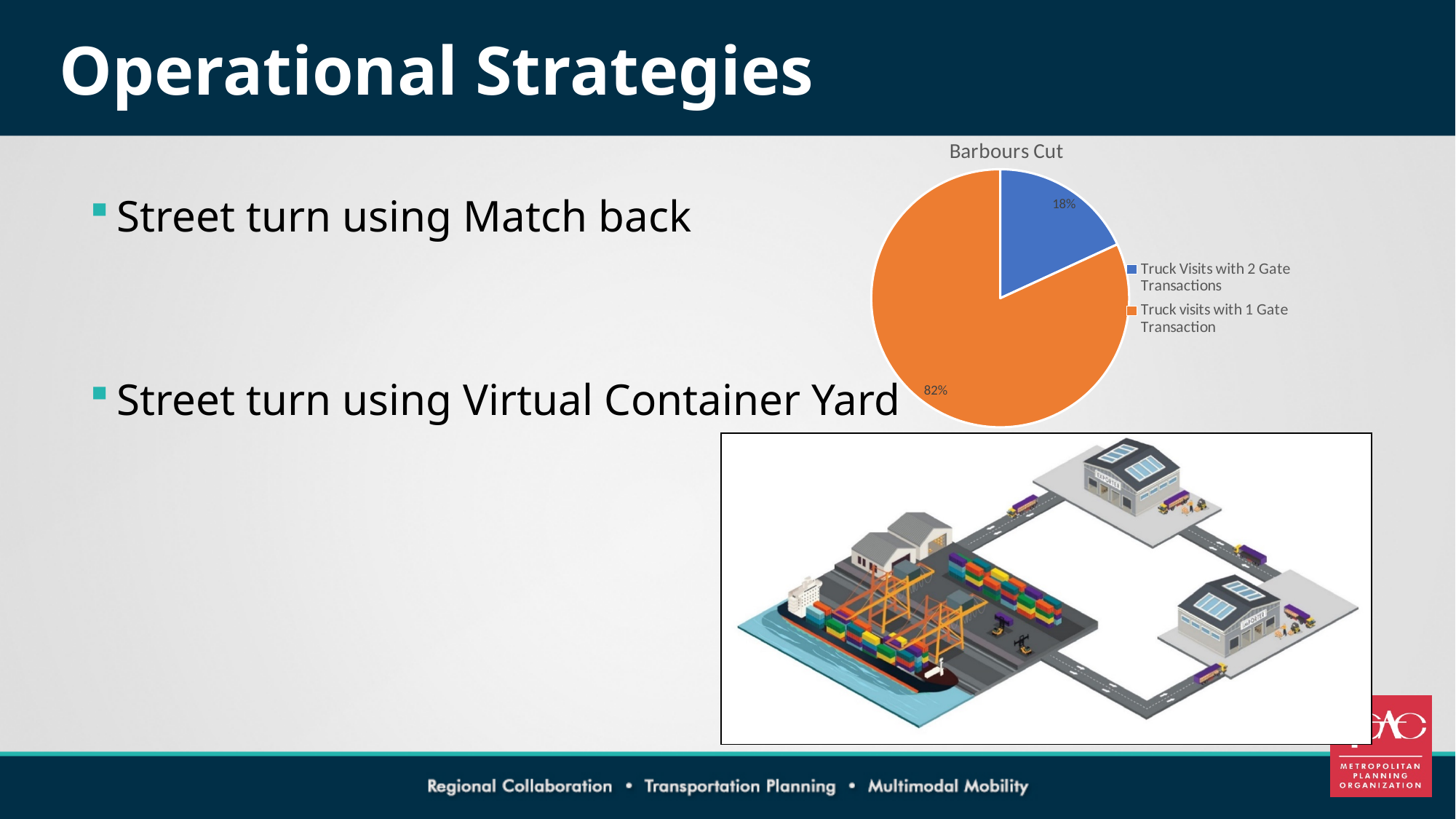
Which category has the largest slice of the pie? Truck visits with 1 Gate Transaction What share of the pie is Truck Visits with 2 Gate Transactions? 18% What is the difference in percentage points between the 1 Gate Transaction slice and the 2 Gate Transactions slice? 64 What colour is the slice for Truck Visits with 2 Gate Transactions? blue How many categories does the pie chart show? 2 What share of the pie is Truck visits with 1 Gate Transaction? 82% Which is larger: Truck Visits with 2 Gate Transactions or Truck visits with 1 Gate Transaction? Truck visits with 1 Gate Transaction What kind of chart is shown on the slide? pie chart What is the title of the pie chart? Barbours Cut Which category has the smallest slice of the pie? Truck Visits with 2 Gate Transactions